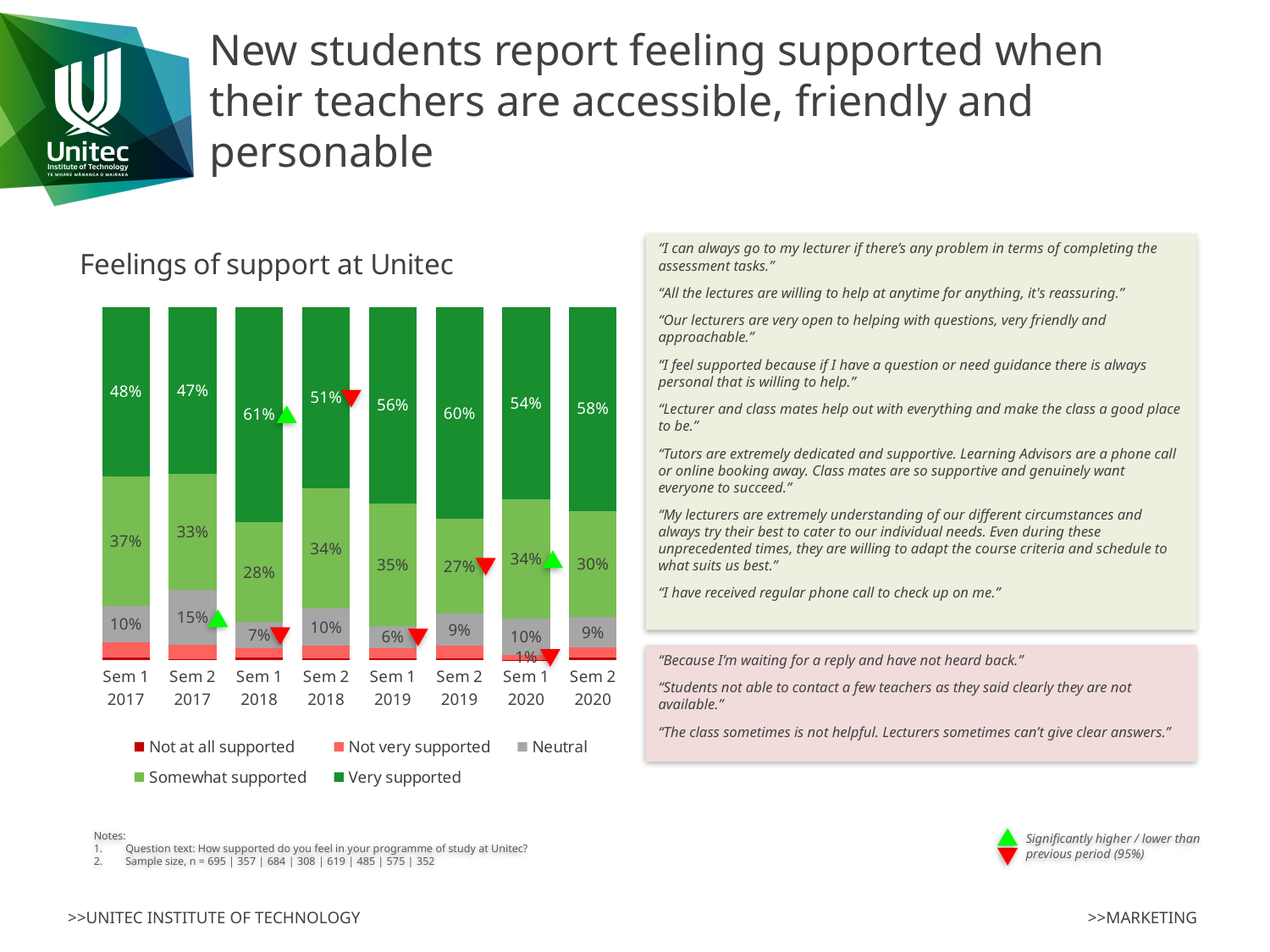
In which semester was the 'Very supported' percentage highest? Sem 1 2018 How many series does the chart legend list? 5 How many semesters (categories) are shown on the x axis of the chart? 8 What percentage of students were 'Neutral' in Sem 2 2017? 15% What percentage of students were 'Not very supported' in Sem 1 2020? 1% What type of chart is shown on the slide? Stacked bar chart What percentage of students were 'Very supported' in Sem 1 2018? 61% What percentage of students were 'Somewhat supported' in Sem 2 2019? 27% What is the difference between the 'Very supported' percentages in Sem 2 2020 and Sem 1 2020? 4% In which semester was the 'Neutral' percentage lowest? Sem 1 2019 What is the title of the chart? Feelings of support at Unitec Which semester had a higher 'Somewhat supported' percentage, Sem 1 2017 or Sem 1 2018? Sem 1 2017